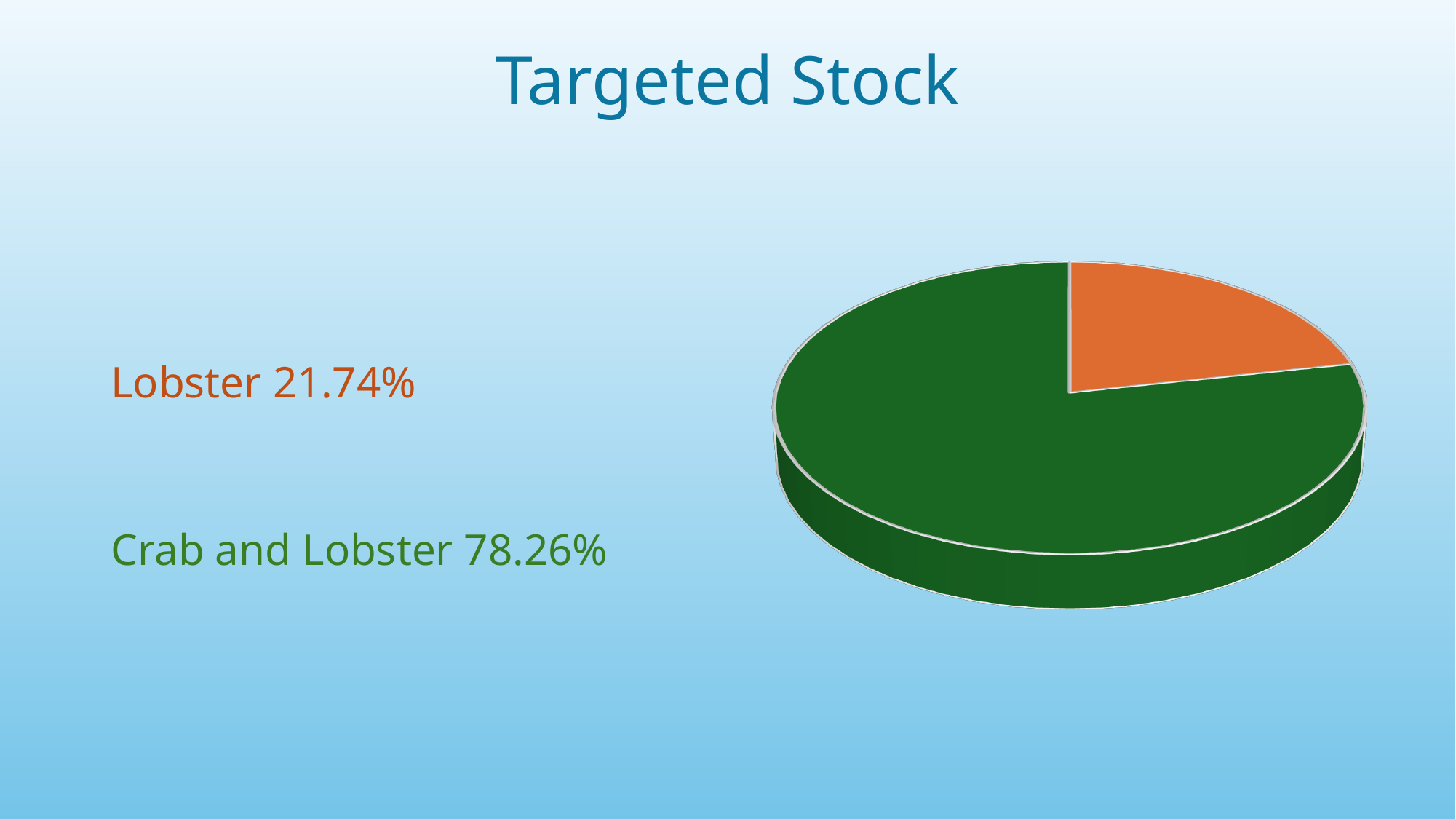
What is the title of the chart? Targeted Stock What is the difference in percentage points between the Crab and Lobster share and the Lobster share? 56.52 What kind of chart is shown on the slide? pie chart What colour is the Lobster slice? orange Which category has the largest slice of the pie? Crab and Lobster How many slices does the pie chart have? 2 Which category has the smallest slice of the pie? Lobster What share of the pie does Crab and Lobster represent? 78.26% Which is larger, the share for Lobster or the share for Crab and Lobster? Crab and Lobster What share of the pie does Lobster represent? 21.74%